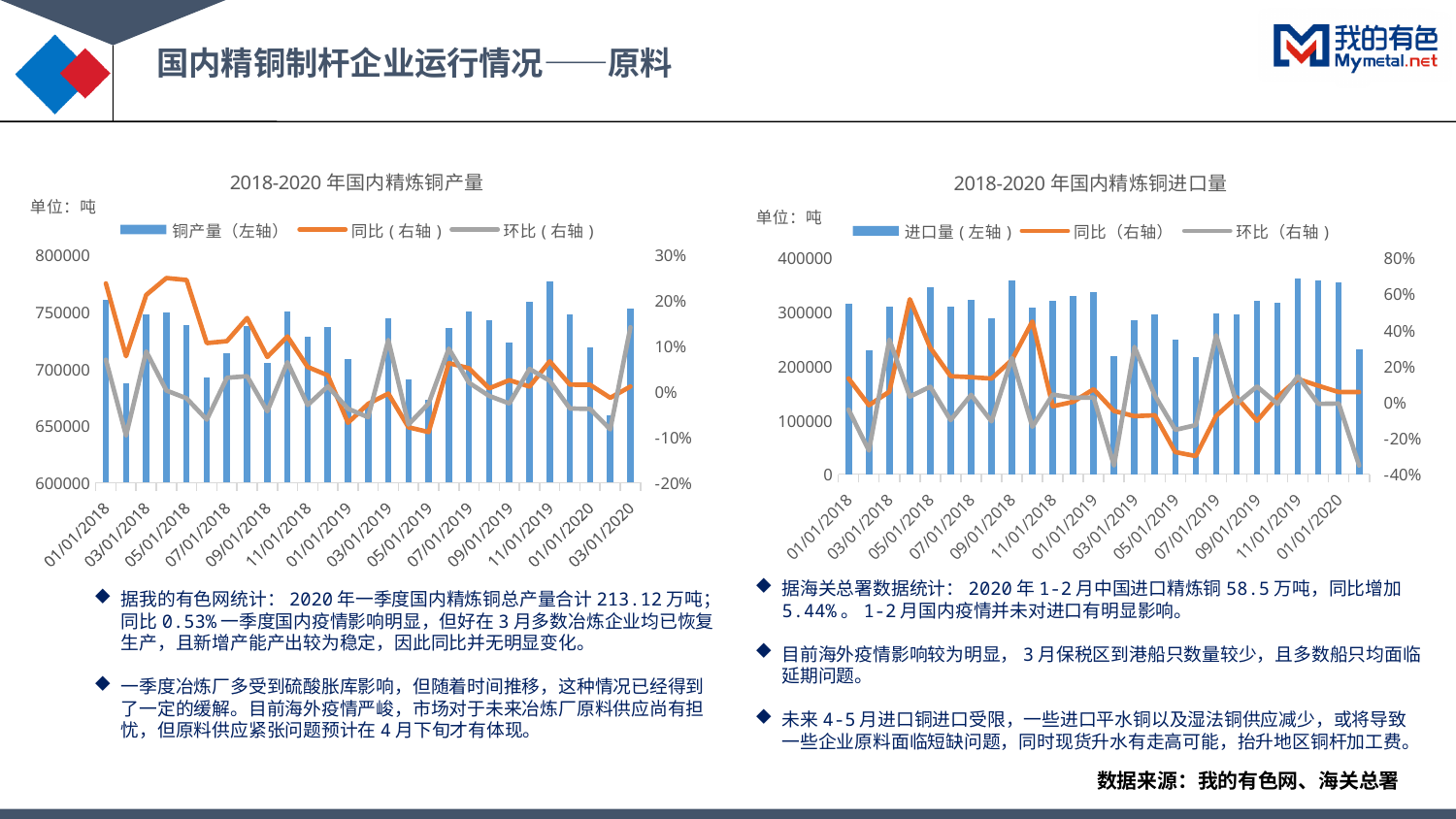
In the right chart (2018-2020 年国内精炼铜进口量), is the bar value for 03/01/2019 greater or less than 300000? less What unit is shown for the right chart (2018-2020 年国内精炼铜进口量)? 吨 In the right chart (2018-2020 年国内精炼铜进口量), is the bar value for the last month shown (after 01/01/2020) greater or less than 300000? less In the left chart (2018-2020 年国内精炼铜产量), is the bar value for 11/01/2019 greater or less than 750000? greater How many series does the legend of the left chart (2018-2020 年国内精炼铜产量) list? 3 How many series does the legend of the right chart (2018-2020 年国内精炼铜进口量) list? 3 In the left chart (2018-2020 年国内精炼铜产量), which series is plotted as bars? 铜产量（左轴） What is the maximum value shown on the left vertical axis of the right chart (2018-2020 年国内精炼铜进口量)? 400000 What kind of chart is the left chart titled 2018-2020 年国内精炼铜产量? A bar chart combined with line series